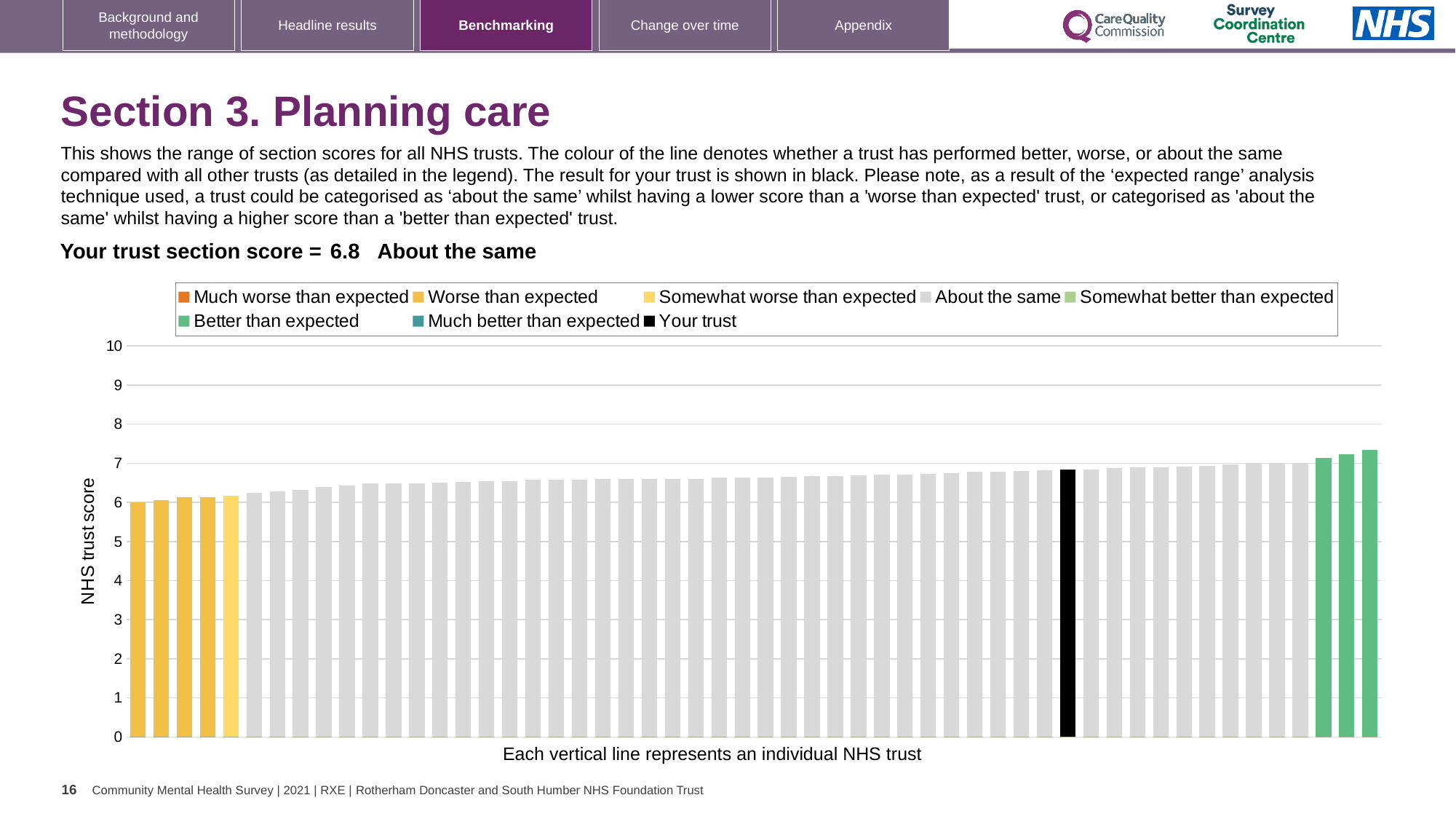
What kind of chart is shown on the slide? bar chart Is the value of the leftmost bar greater or less than 5? greater Is the value of the black bar (your trust) greater or less than 6? greater How many bars are coloured green (better than expected)? 3 Which is larger, the value of the rightmost bar or the value of the leftmost bar? the rightmost bar Which category is your trust placed in for this section? About the same Do the bar values rise or fall from left to right along the x axis? rise How many entries does the chart legend list? 8 Is the value of the rightmost bar greater or less than 8? less What is the section score for your trust shown on the slide? 6.8 What is the label on the vertical axis of the chart? NHS trust score What colour is used for the bar representing your trust? black